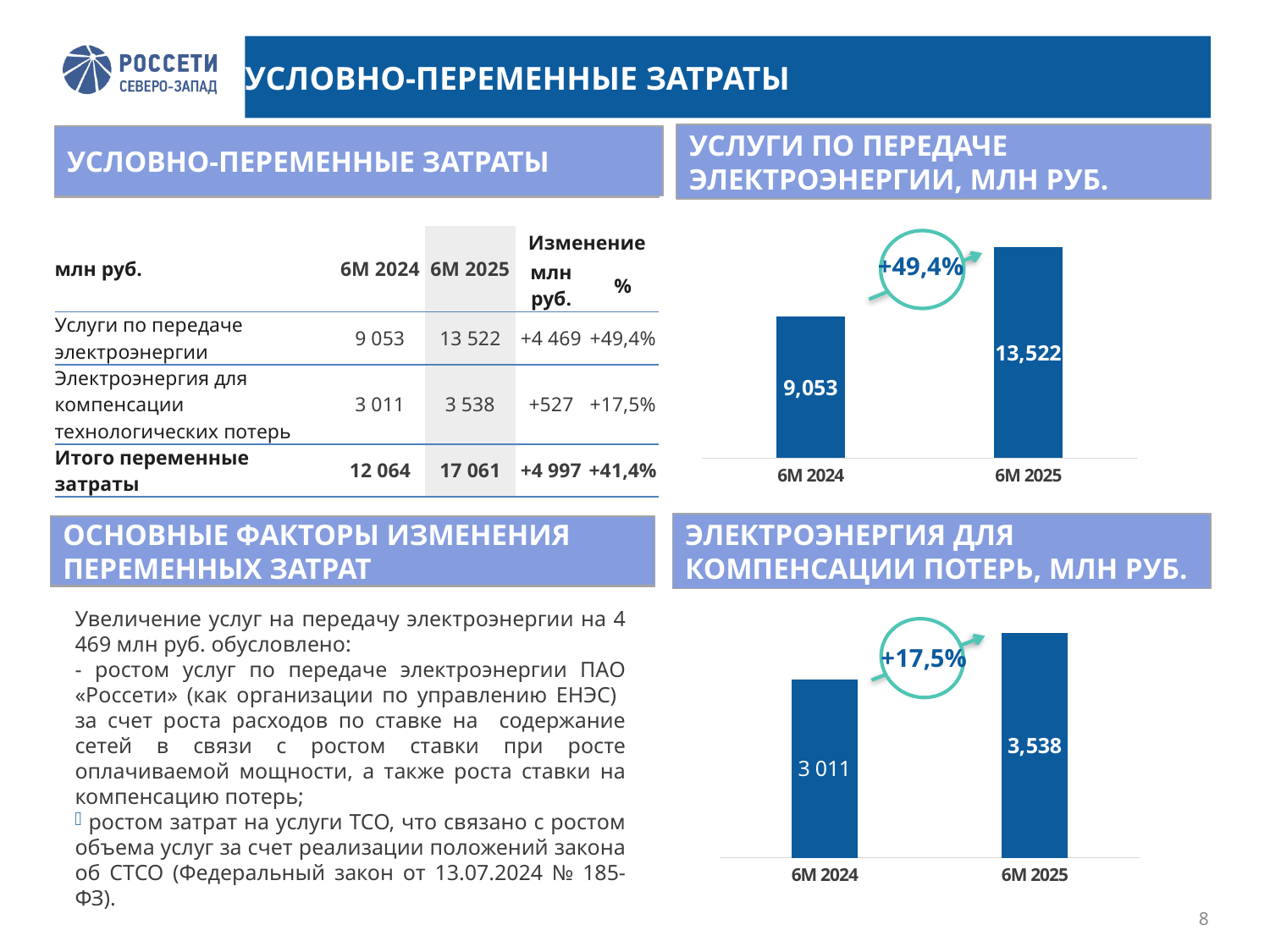
What kind of chart is the one titled 'УСЛУГИ ПО ПЕРЕДАЧЕ ЭЛЕКТРОЭНЕРГИИ, МЛН РУБ.'? Bar chart In the chart titled 'УСЛУГИ ПО ПЕРЕДАЧЕ ЭЛЕКТРОЭНЕРГИИ, МЛН РУБ.', which period has the higher value? 6M 2025 In the chart titled 'УСЛУГИ ПО ПЕРЕДАЧЕ ЭЛЕКТРОЭНЕРГИИ, МЛН РУБ.', what is the difference between the 6M 2025 and 6M 2024 values? 4,469 In the chart titled 'УСЛУГИ ПО ПЕРЕДАЧЕ ЭЛЕКТРОЭНЕРГИИ, МЛН РУБ.', what is the value for 6M 2024? 9,053 How many bars are in the chart titled 'ЭЛЕКТРОЭНЕРГИЯ ДЛЯ КОМПЕНСАЦИИ ПОТЕРЬ, МЛН РУБ.'? 2 In the chart titled 'ЭЛЕКТРОЭНЕРГИЯ ДЛЯ КОМПЕНСАЦИИ ПОТЕРЬ, МЛН РУБ.', what is the difference between the 6M 2025 and 6M 2024 values? 527 In the chart titled 'ЭЛЕКТРОЭНЕРГИЯ ДЛЯ КОМПЕНСАЦИИ ПОТЕРЬ, МЛН РУБ.', what is the value for 6M 2025? 3,538 In the chart titled 'ЭЛЕКТРОЭНЕРГИЯ ДЛЯ КОМПЕНСАЦИИ ПОТЕРЬ, МЛН РУБ.', what percentage change is shown between 6M 2024 and 6M 2025? +17,5% In the chart titled 'УСЛУГИ ПО ПЕРЕДАЧЕ ЭЛЕКТРОЭНЕРГИИ, МЛН РУБ.', what percentage change is shown between 6M 2024 and 6M 2025? +49,4% In the chart titled 'ЭЛЕКТРОЭНЕРГИЯ ДЛЯ КОМПЕНСАЦИИ ПОТЕРЬ, МЛН РУБ.', which period has the lower value? 6M 2024 In the chart titled 'ЭЛЕКТРОЭНЕРГИЯ ДЛЯ КОМПЕНСАЦИИ ПОТЕРЬ, МЛН РУБ.', what is the value for 6M 2024? 3 011 In the chart titled 'УСЛУГИ ПО ПЕРЕДАЧЕ ЭЛЕКТРОЭНЕРГИИ, МЛН РУБ.', what is the value for 6M 2025? 13,522